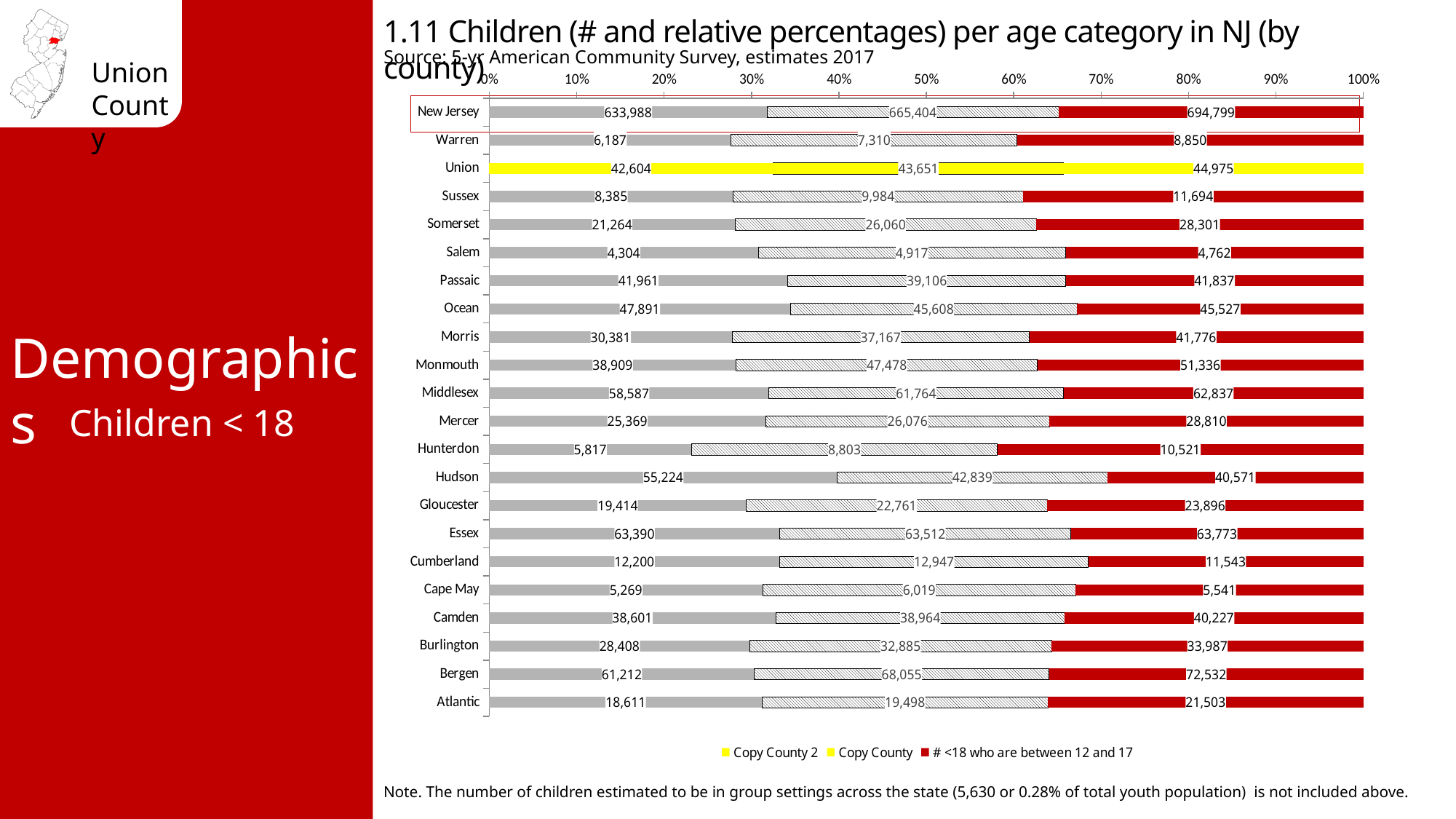
Which county has the lowest value for '# <18 who are between 12 and 17'? Salem How many rows (New Jersey plus counties) are plotted in the chart? 22 What is the value of the leftmost (first) segment for Hudson? 55,224 Is the share of the leftmost segment for Hunterdon greater or less than 30%? less For Union, how much larger is the '# <18 who are between 12 and 17' value (44,975) than the leftmost segment value (42,604)? 2,371 What is the total of the three segments for Union (42,604 + 43,651 + 44,975)? 131,230 What is the value of the '# <18 who are between 12 and 17' segment for Bergen? 72,532 Excluding the New Jersey row, which county has the highest value for '# <18 who are between 12 and 17'? Bergen Which is larger: the '# <18 who are between 12 and 17' value for Essex or for Middlesex? Essex What is the value of the '# <18 who are between 12 and 17' segment for Union? 44,975 How many series does the legend list? 3 What kind of chart is shown on the slide? Stacked bar chart